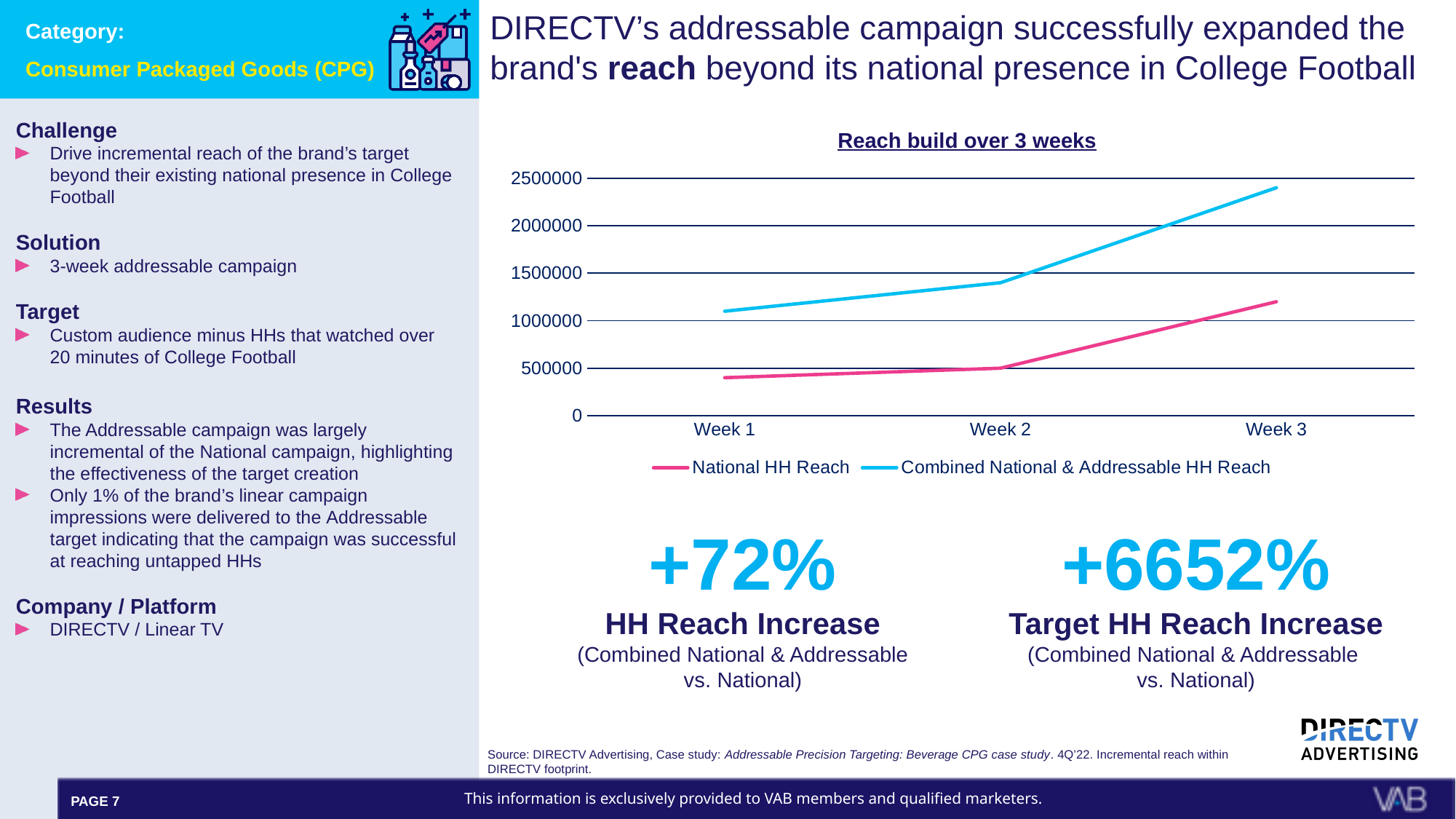
Do the values of the National HH Reach line rise or fall from Week 1 to Week 3? Rise Which colour is the National HH Reach line in the chart? Pink Is the National HH Reach value for Week 3 greater or less than 1000000? greater In Week 3, which series has the larger value: National HH Reach or Combined National & Addressable HH Reach? Combined National & Addressable HH Reach How many series does the chart legend list? 2 What kind of chart is shown on the slide? Line chart Is the Combined National & Addressable HH Reach value for Week 1 greater or less than 1000000? greater What is the title of the chart? Reach build over 3 weeks How many weeks are plotted along the x axis of the chart? 3 Is the National HH Reach value for Week 1 greater or less than 500000? less In which week does the Combined National & Addressable HH Reach line reach its highest value? Week 3